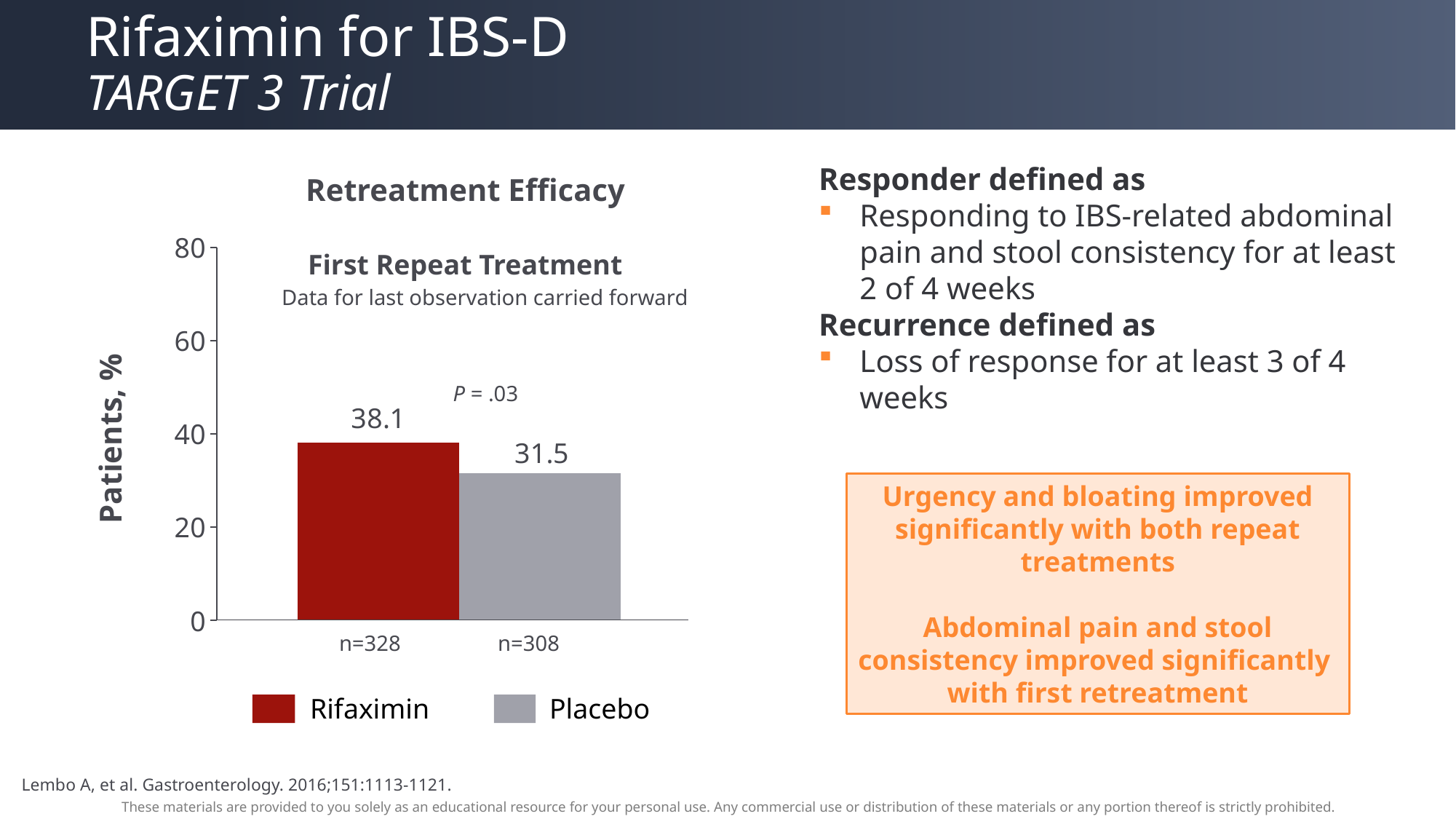
Which group has the lower percentage of patients in the Retreatment Efficacy chart? Placebo What is the difference between the Rifaximin and Placebo values in the Retreatment Efficacy chart? 6.6 How many series does the legend of the Retreatment Efficacy chart list? 2 What is the value for Placebo in the Retreatment Efficacy chart? 31.5 How many bars are plotted in the Retreatment Efficacy chart? 2 What is the y-axis label of the Retreatment Efficacy chart? Patients, % Which group has the higher percentage of patients in the Retreatment Efficacy chart? Rifaximin What kind of chart is the Retreatment Efficacy chart? Bar chart Is the value for Rifaximin greater or less than 40 in the Retreatment Efficacy chart? less Is the value for Placebo greater or less than 20 in the Retreatment Efficacy chart? greater What P value is shown in the Retreatment Efficacy chart? P = .03 What is the value for Rifaximin in the Retreatment Efficacy chart? 38.1